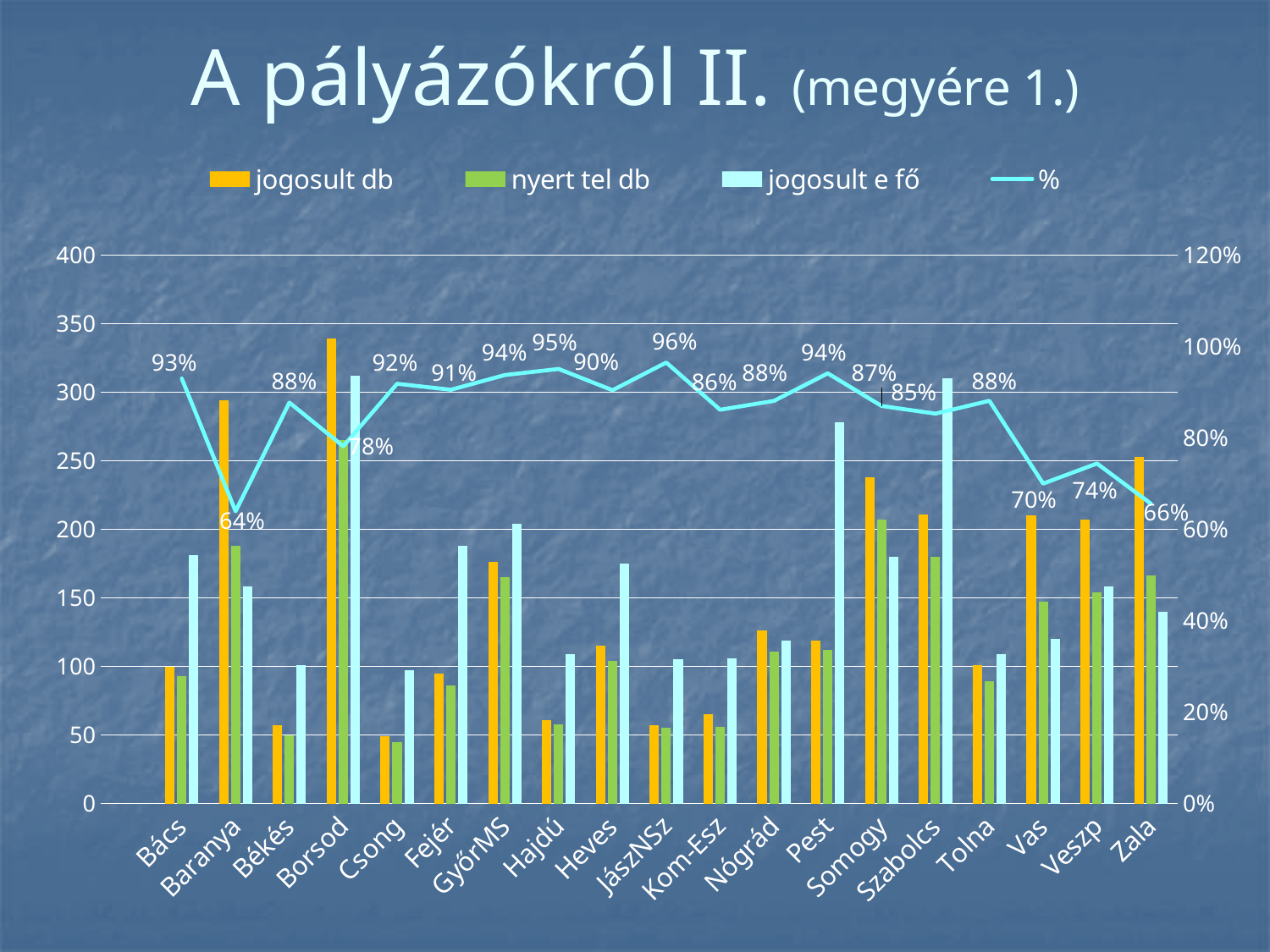
Which county has the highest % value on the line? JászNSz What is the % value for Vas? 70% Which has a higher % value, Bács or Zala? Bács Is the jogosult db value for Borsod greater or less than 300? greater Which series is drawn as a line rather than bars? % Which county has the lowest % value on the line? Baranya How many counties are shown on the x axis? 19 What is the % value for Baranya? 64% What is the difference between the % value for JászNSz and the % value for Baranya? 32% Is the jogosult e fő value for Pest greater or less than 250? greater What is the % value for JászNSz? 96% How many series does the legend list? 4